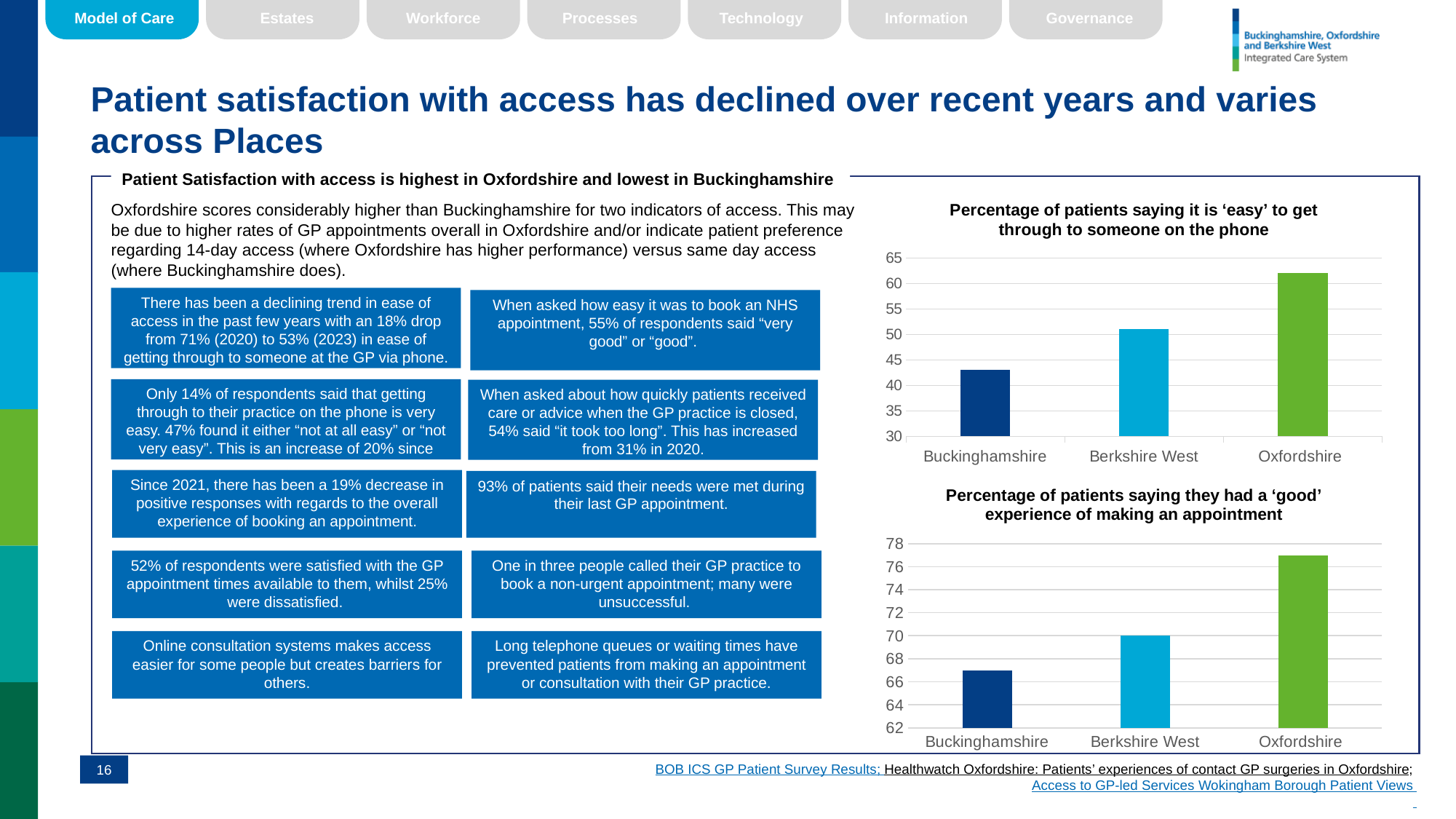
What kind of chart is 'Percentage of patients saying they had a ‘good’ experience of making an appointment'? bar chart In the chart 'Percentage of patients saying they had a ‘good’ experience of making an appointment', which Place has the highest value? Oxfordshire In the chart 'Percentage of patients saying they had a ‘good’ experience of making an appointment', which is larger, the value for Berkshire West or the value for Buckinghamshire? Berkshire West In the chart 'Percentage of patients saying it is ‘easy’ to get through to someone on the phone', which Place has the highest value? Oxfordshire In the chart 'Percentage of patients saying it is ‘easy’ to get through to someone on the phone', is the value for Berkshire West greater or less than 50? greater How many Places are shown in the chart 'Percentage of patients saying it is ‘easy’ to get through to someone on the phone'? 3 In the chart 'Percentage of patients saying they had a ‘good’ experience of making an appointment', is the value for Oxfordshire greater or less than 76? greater In the chart 'Percentage of patients saying it is ‘easy’ to get through to someone on the phone', is the value for Oxfordshire greater or less than 60? greater In the chart 'Percentage of patients saying they had a ‘good’ experience of making an appointment', which Place has the lowest value? Buckinghamshire In the chart 'Percentage of patients saying it is ‘easy’ to get through to someone on the phone', which Place has the lowest value? Buckinghamshire